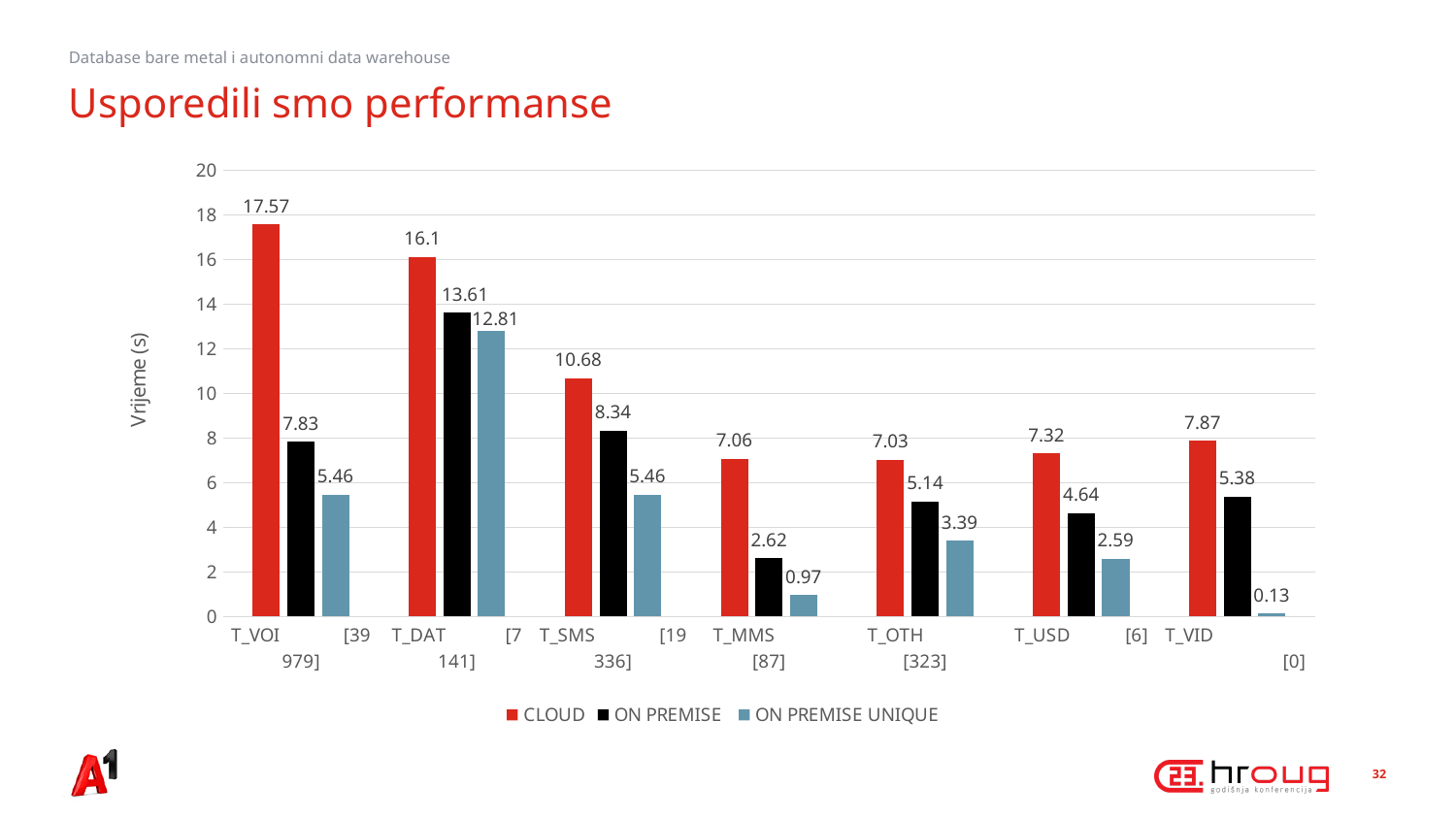
Which category has the highest CLOUD value? T_VOI How many categories are shown on the x axis? 7 Is the CLOUD value for T_DAT greater or less than 14? greater Which category has the lowest ON PREMISE UNIQUE value? T_VID How many series does the legend list? 3 What is the CLOUD value for T_VOI? 17.57 What is the ON PREMISE UNIQUE value for T_VID? 0.13 What is the ON PREMISE value for T_DAT? 13.61 Which is larger for T_SMS, the ON PREMISE value or the ON PREMISE UNIQUE value? ON PREMISE What is the label of the y axis? Vrijeme (s) What is the difference between the CLOUD and ON PREMISE values for T_VOI? 9.74 What kind of chart is shown on the slide? bar chart